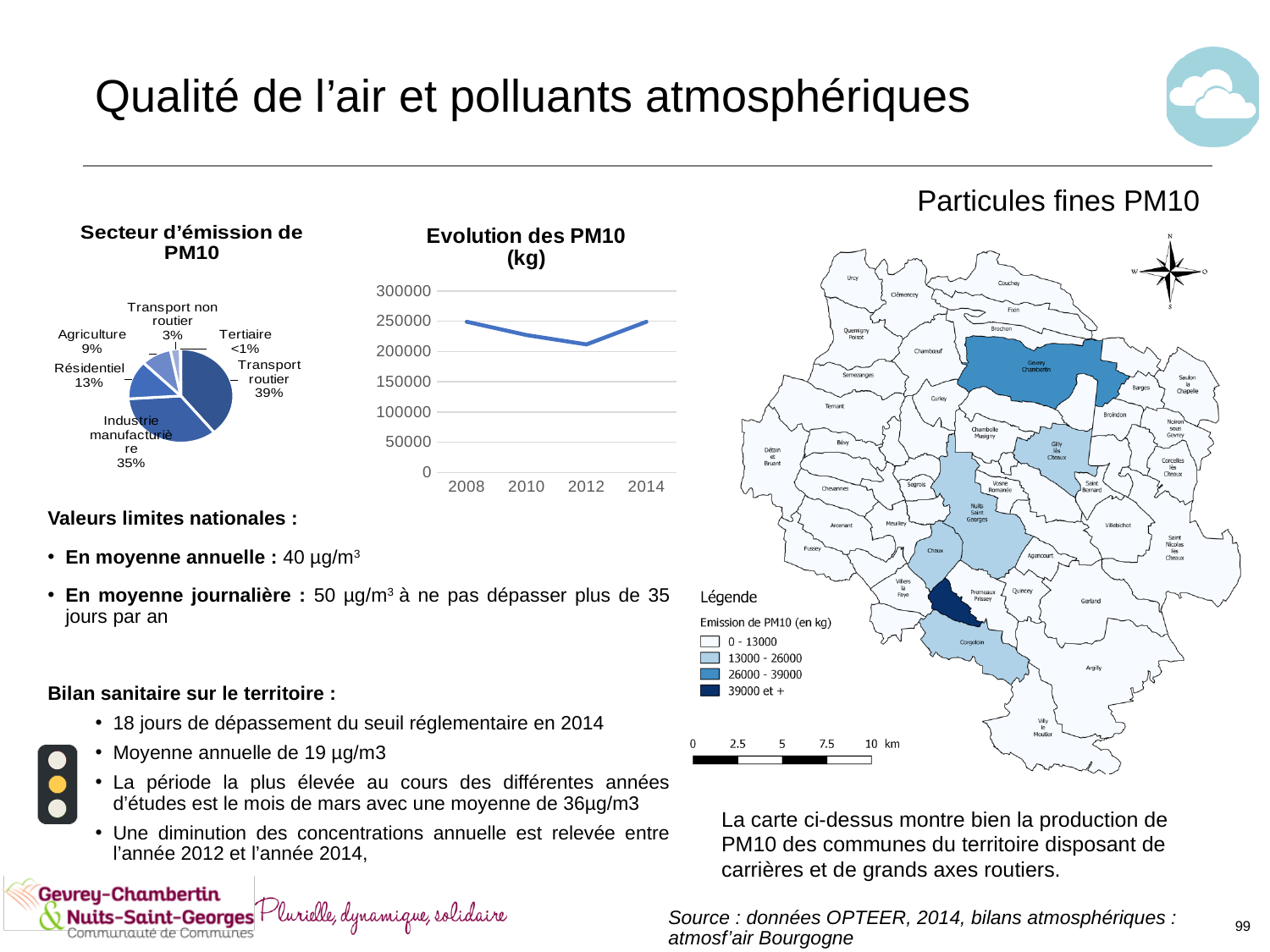
What type of chart is 'Evolution des PM10 (kg)'? Line chart In the chart 'Evolution des PM10 (kg)', which year has the lowest value? 2012 In the pie chart 'Secteur d'émission de PM10', what share does Résidentiel have? 13% In the chart 'Evolution des PM10 (kg)', how do the values change from 2008 to 2012? They fall In the pie chart 'Secteur d'émission de PM10', which is larger: Résidentiel or Agriculture? Résidentiel In the chart 'Evolution des PM10 (kg)', is the value for 2012 greater or less than 250000? less In the pie chart 'Secteur d'émission de PM10', which sector has the smallest share? Tertiaire How many sectors are shown in the pie chart 'Secteur d'émission de PM10'? 6 In the pie chart 'Secteur d'émission de PM10', what share does Transport routier have? 39% In the pie chart 'Secteur d'émission de PM10', what is the difference in percentage points between Agriculture and Transport non routier? 6 In the pie chart 'Secteur d'émission de PM10', what share does Industrie manufacturière have? 35% In the pie chart 'Secteur d'émission de PM10', which sector has the largest share? Transport routier